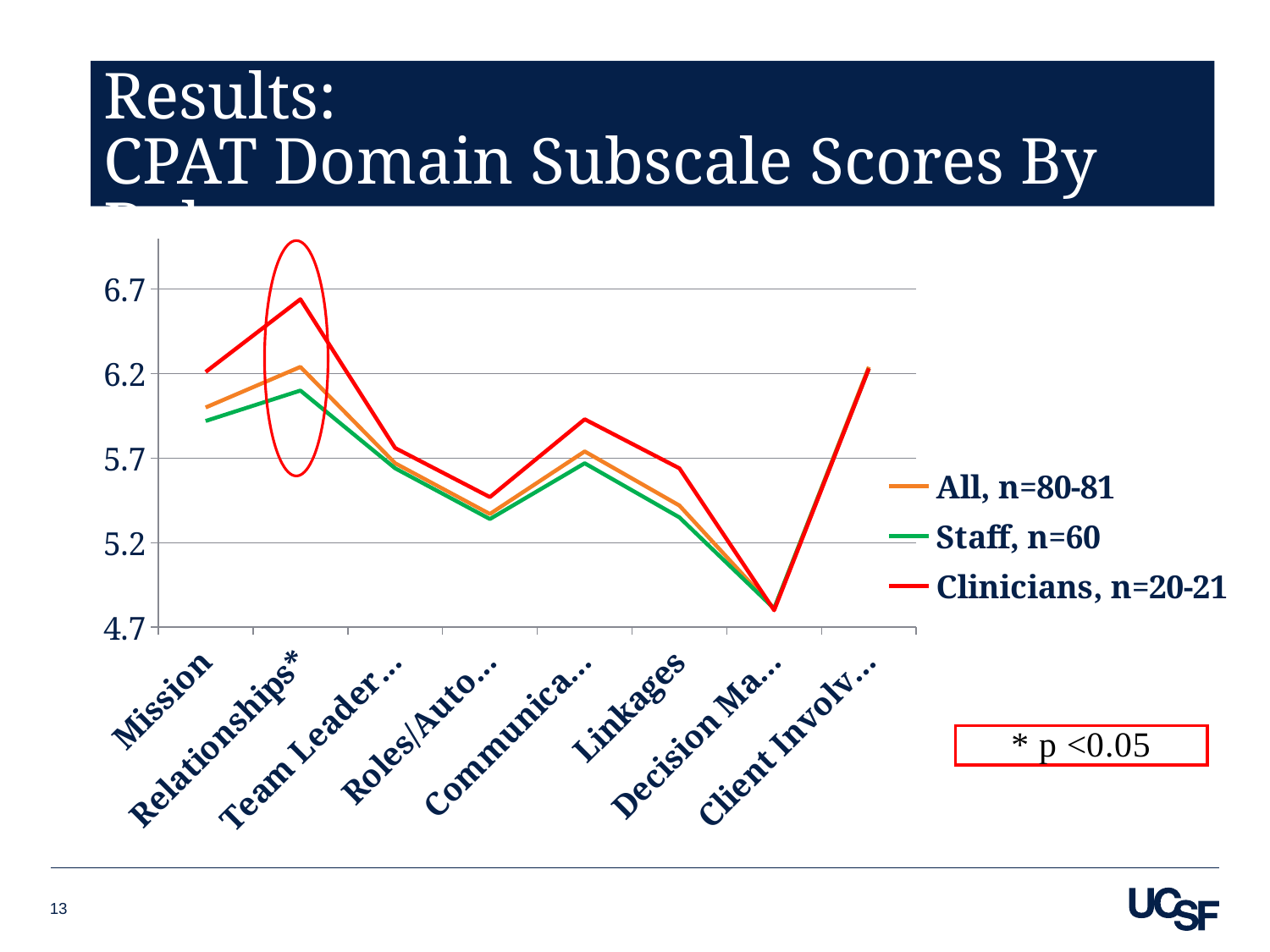
Which colour is used for the Staff, n=60 series? green Which category has the lowest value for the Clinicians, n=20-21 series? Decision Ma... What kind of chart is shown on the slide? line chart At Relationships*, which series has the larger value: Clinicians, n=20-21 or Staff, n=60? Clinicians, n=20-21 Do the Clinicians, n=20-21 values rise or fall from Relationships* to Communica...? fall Which category is circled in red on the chart? Relationships* How many categories are shown along the x axis? 8 Is the Staff, n=60 value for Decision Ma... greater or less than 5.2? less Is the Staff, n=60 value for Mission greater or less than 5.7? greater Which category has the highest value for the Clinicians, n=20-21 series? Relationships* How many series does the legend list? 3 Is the Clinicians, n=20-21 value for Relationships* greater or less than 6.2? greater